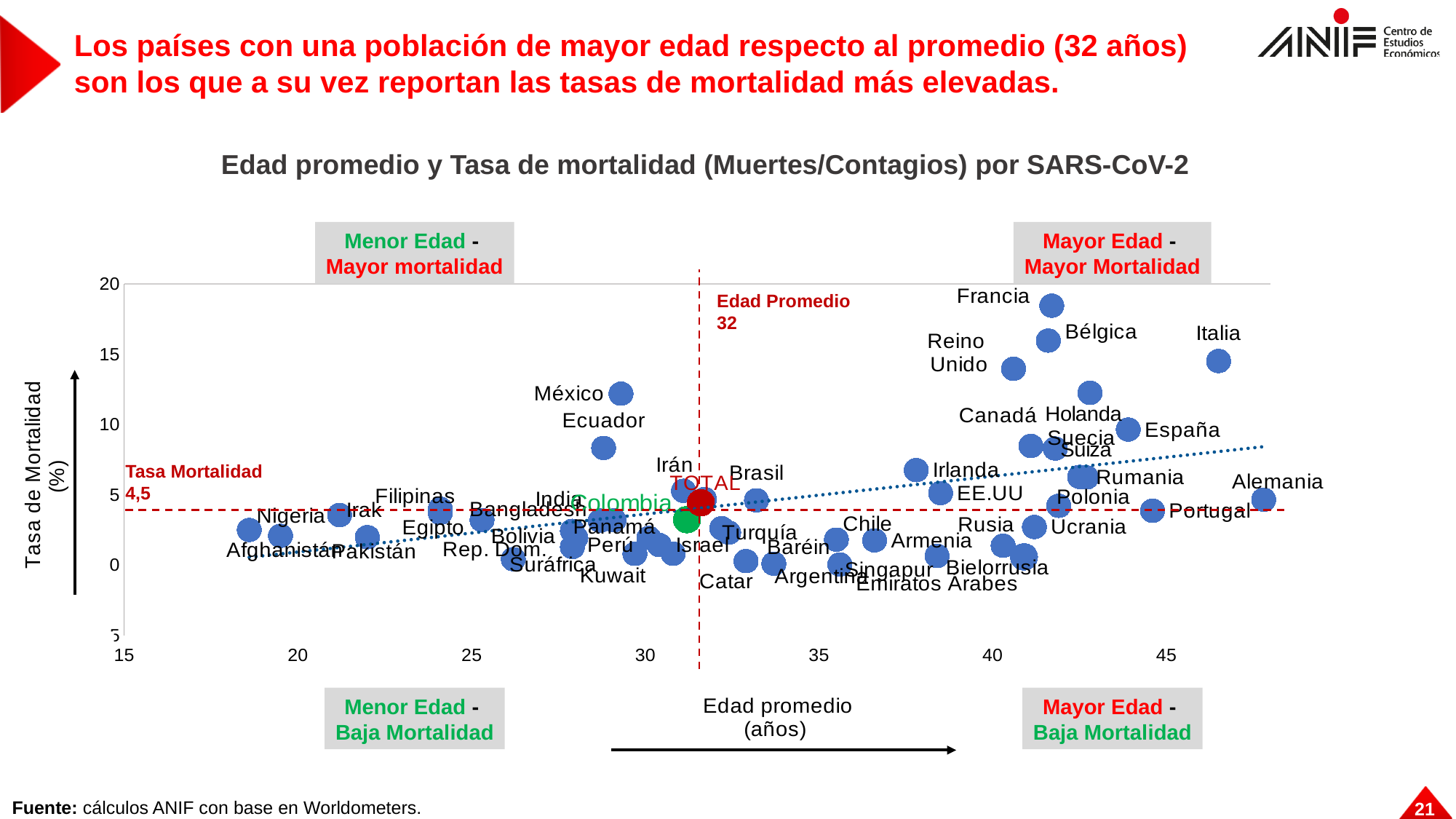
Is the mortality rate for México greater or less than 10? greater What kind of chart is shown on the slide? scatter chart Which country has the lowest average age in the chart? Afghanistán Is the mortality rate for Francia greater or less than 15? greater Which country has the highest average age in the chart? Alemania Which country's point is coloured green in the chart? Colombia Which country has the highest mortality rate in the chart? Francia What is the title of the chart? Edad promedio y Tasa de mortalidad (Muertes/Contagios) por SARS-CoV-2 What mortality rate (Tasa Mortalidad) does the horizontal dashed reference line mark? 4,5 Is the average age for Afghanistán greater or less than 20? less What average age (Edad Promedio) does the vertical dashed reference line mark? 32 Which has a higher mortality rate, Bélgica or Reino Unido? Bélgica